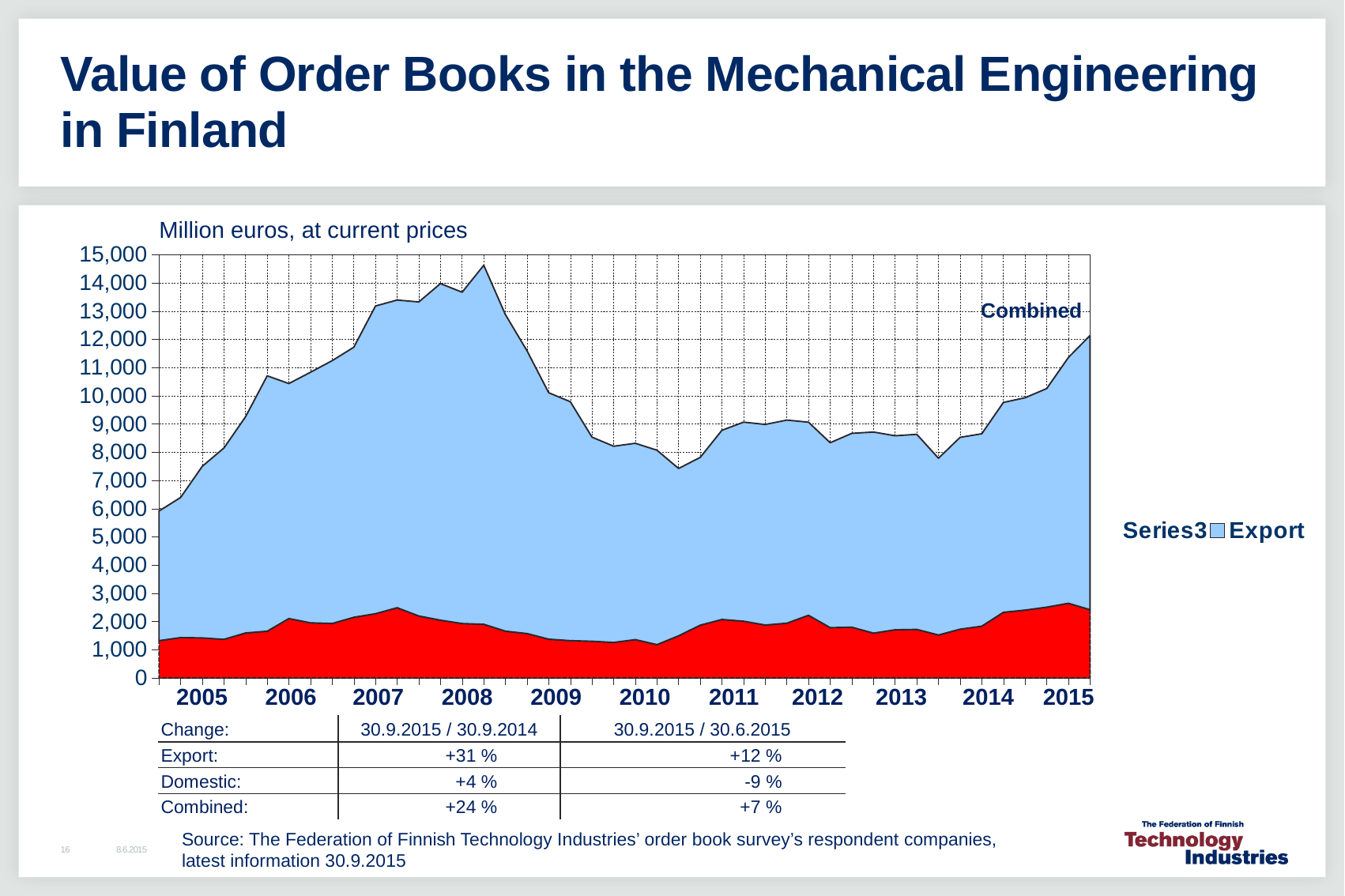
In which year is the Combined value at its lowest? 2005 Is the Combined value at the end of 2015 greater or less than 11,000? greater Does the Combined value rise or fall between its 2008 peak and 2010? fall Is the peak Combined value in 2008 greater or less than 14,000? greater What are the two entries in the chart legend? Series3 and Export In which year does the Combined value reach its highest point? 2008 Does the Combined value rise or fall from 2013 to 2015? rise What unit label is printed above the chart? Million euros, at current prices How many series does the legend list? 2 Is the Combined value at its 2010 low point greater or less than 8,000? less How many year labels are shown on the x axis? 11 What kind of chart is shown on the slide? Area chart